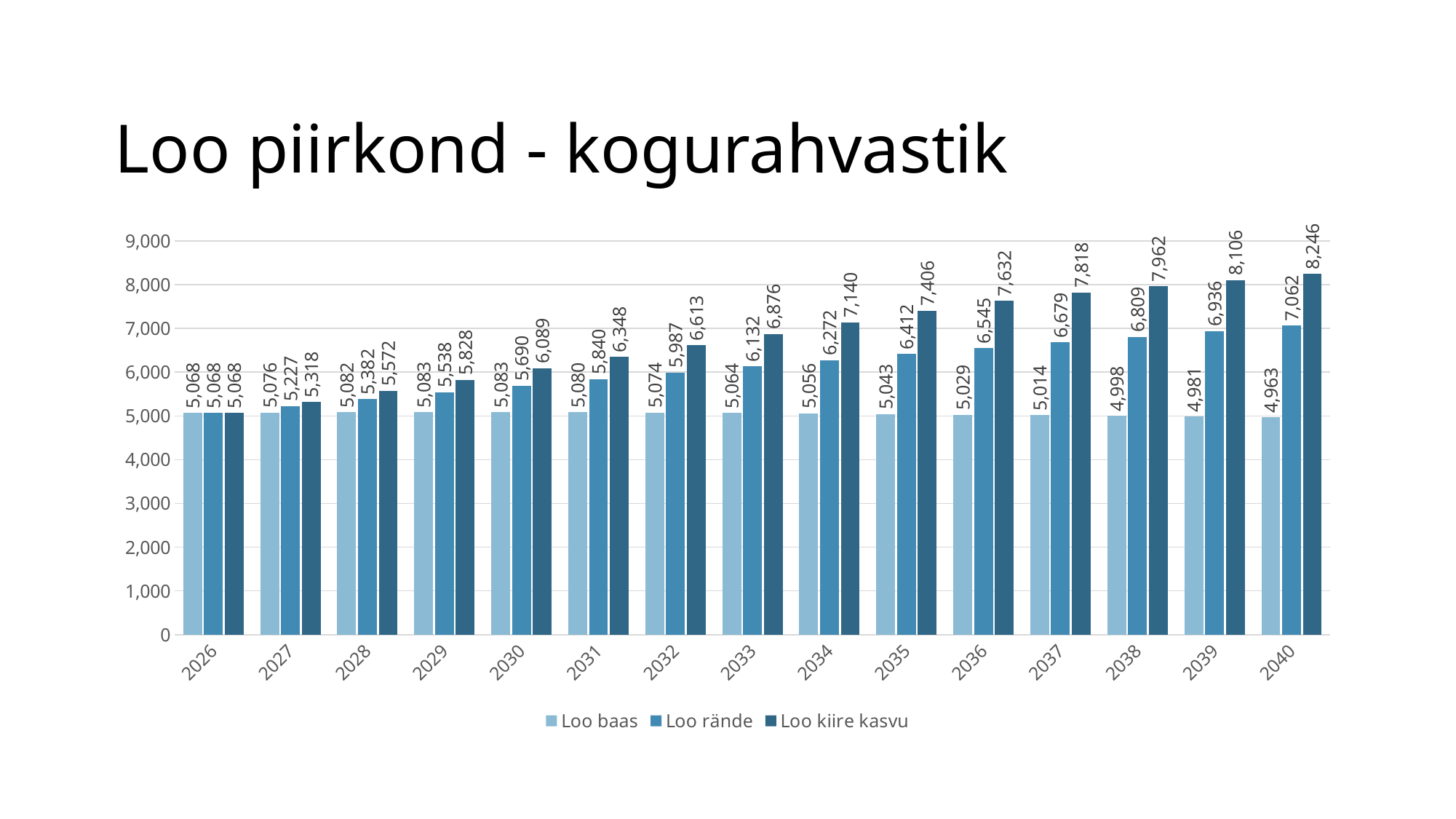
What is the value for Loo rände in 2033? 6,132 Which year has the highest value for Loo kiire kasvu? 2040 How many series does the legend list? 3 What is the difference between Loo kiire kasvu and Loo baas in 2040? 3,283 Which is larger in 2035: Loo rände or Loo kiire kasvu? Loo kiire kasvu How many years are shown on the x axis? 15 What kind of chart is shown on the slide? Bar chart What is the value for Loo baas in 2026? 5,068 Which year has the lowest value for Loo baas? 2040 Do the values for Loo baas rise or fall from 2030 to 2040? Fall What is the title of the chart? Loo piirkond - kogurahvastik What is the value for Loo kiire kasvu in 2040? 8,246